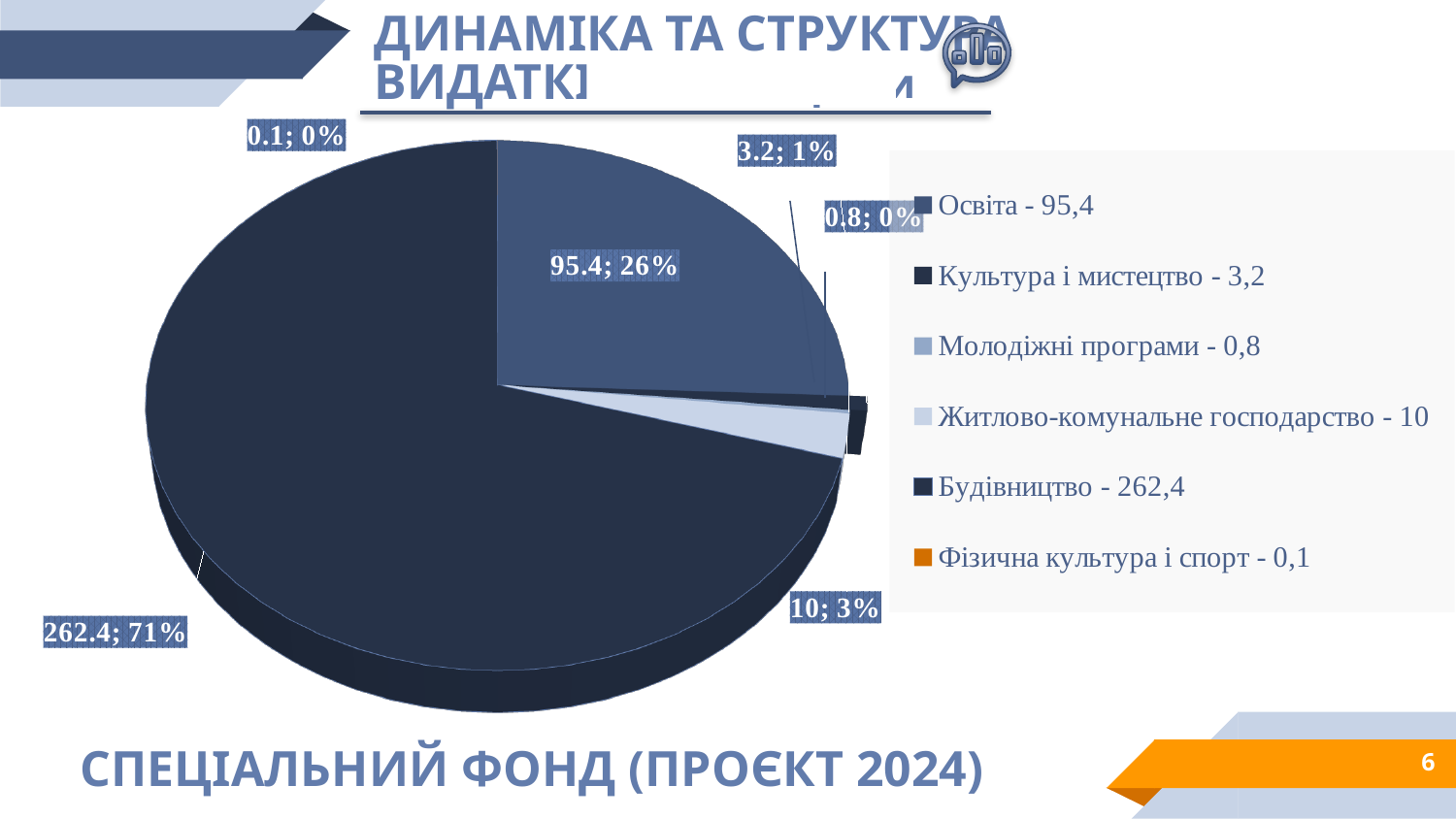
What share of the pie does Житлово-комунальне господарство represent? 3% What share of the pie does Освіта represent? 26% What value is shown for Освіта in the pie chart? 95.4 What kind of chart is shown on the slide? Pie chart What value is shown for Будівництво in the pie chart? 262.4 How many slices (categories) does the pie chart have? 6 What share of the pie does Будівництво represent? 71% Which category has the smallest value in the pie chart? Фізична культура і спорт What value is shown for Житлово-комунальне господарство in the pie chart? 10 Which category has the largest slice in the pie chart? Будівництво How many entries does the legend of the pie chart list? 6 What is the difference between the values for Будівництво and Освіта? 167